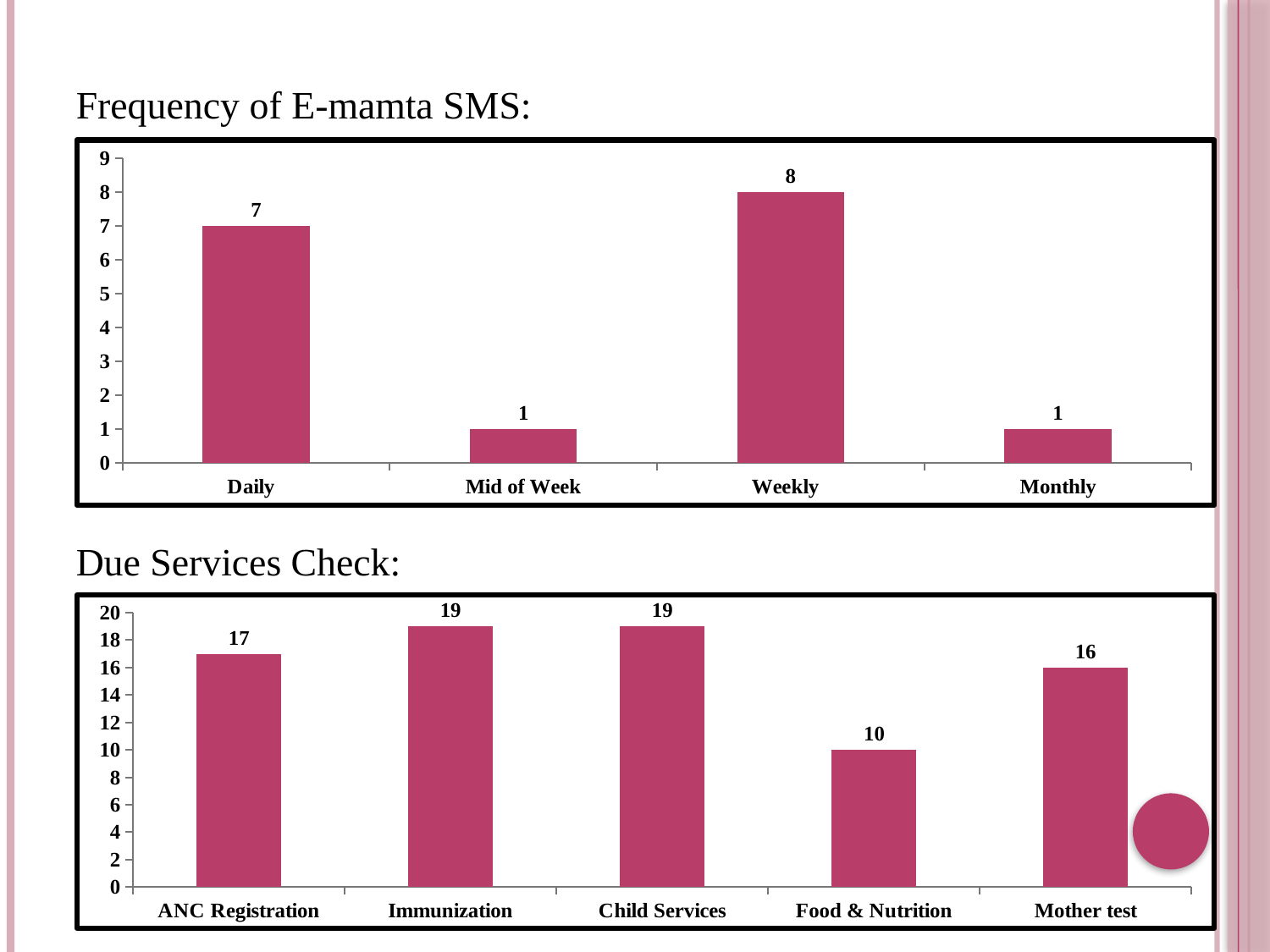
In the 'Due Services Check' chart, what is the difference between Immunization and Food & Nutrition? 9 In the 'Frequency of E-mamta SMS' chart, how many categories are shown on the x axis? 4 In the 'Frequency of E-mamta SMS' chart, what is the value for Mid of Week? 1 In the 'Due Services Check' chart, which is larger, ANC Registration or Mother test? ANC Registration In the 'Due Services Check' chart, what is the value for Food & Nutrition? 10 In the 'Due Services Check' chart, which category has the lowest value? Food & Nutrition In the 'Frequency of E-mamta SMS' chart, which category has the highest value? Weekly In the 'Frequency of E-mamta SMS' chart, what is the value for Weekly? 8 What kind of chart is the 'Due Services Check' chart? Bar chart In the 'Due Services Check' chart, how many categories are shown on the x axis? 5 In the 'Due Services Check' chart, what is the value for Mother test? 16 In the 'Frequency of E-mamta SMS' chart, what is the difference between the Weekly and Daily values? 1